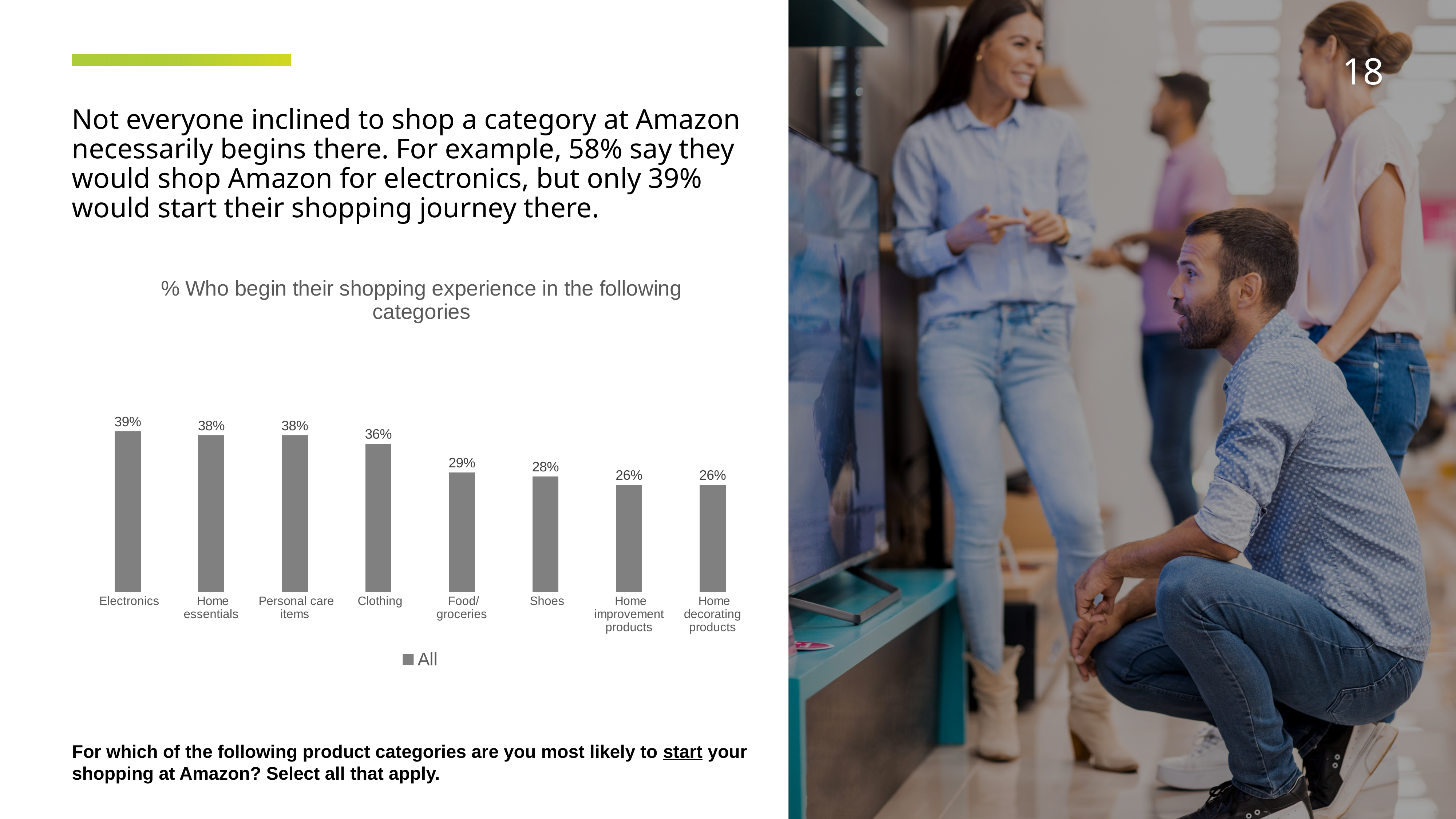
What is the value shown for Food/groceries? 29% Which category has the highest value in the chart? Electronics Which is larger, the value for Personal care items or the value for Shoes? Personal care items What is the title of the chart? % Who begin their shopping experience in the following categories What percentage begin their shopping experience at Amazon for Electronics? 39% What is the difference between the values for Clothing and Food/groceries? 7% What kind of chart is shown on the slide? Bar chart What is the difference between the values for Electronics and Home decorating products? 13% What is the value shown for Shoes? 28% What is the value shown for Clothing? 36% How many product categories are shown in the chart? 8 How many series does the legend list? 1